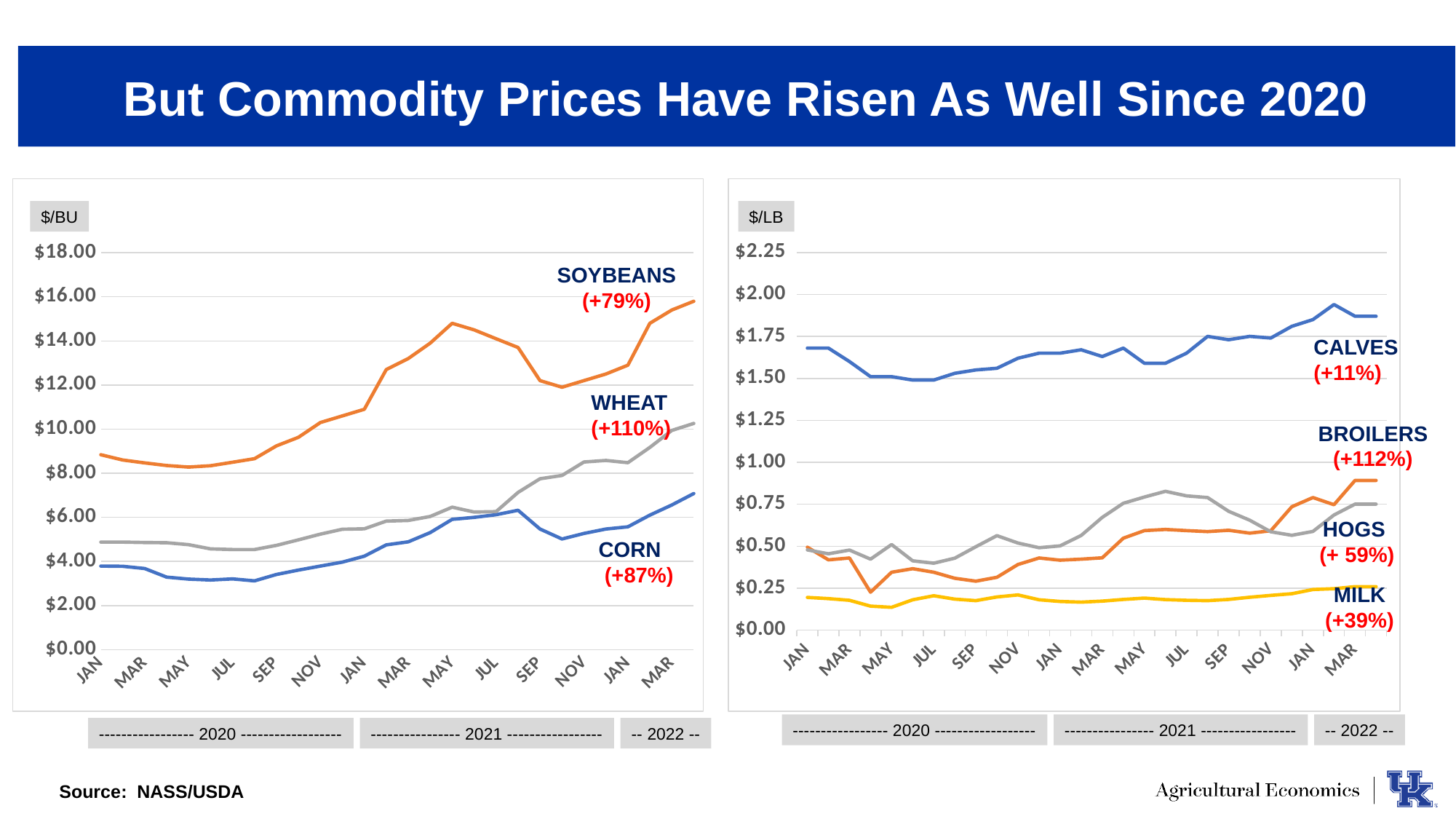
In the right chart ($/LB), is the CALVES value in January 2020 greater or less than $1.50? greater In the left chart ($/BU), which commodity has the largest printed percentage increase? WHEAT In the right chart ($/LB), what percentage change is printed next to the BROILERS line? +112% In the right chart ($/LB), which commodity line is lowest throughout the period shown? MILK In the left chart ($/BU), is the SOYBEANS value in May 2021 greater or less than $14.00? greater How many commodity lines are plotted in the right chart ($/LB)? 4 In the left chart ($/BU), which commodity line is highest throughout the period shown? SOYBEANS In the left chart ($/BU), what percentage change is printed next to the WHEAT line? +110% In the left chart ($/BU), what percentage change is printed next to the CORN line? +87% In the right chart ($/LB), which commodity has the smallest printed percentage increase? CALVES What kind of chart is the left chart ($/BU)? line chart In the right chart ($/LB), what percentage change is printed next to the MILK line? +39%